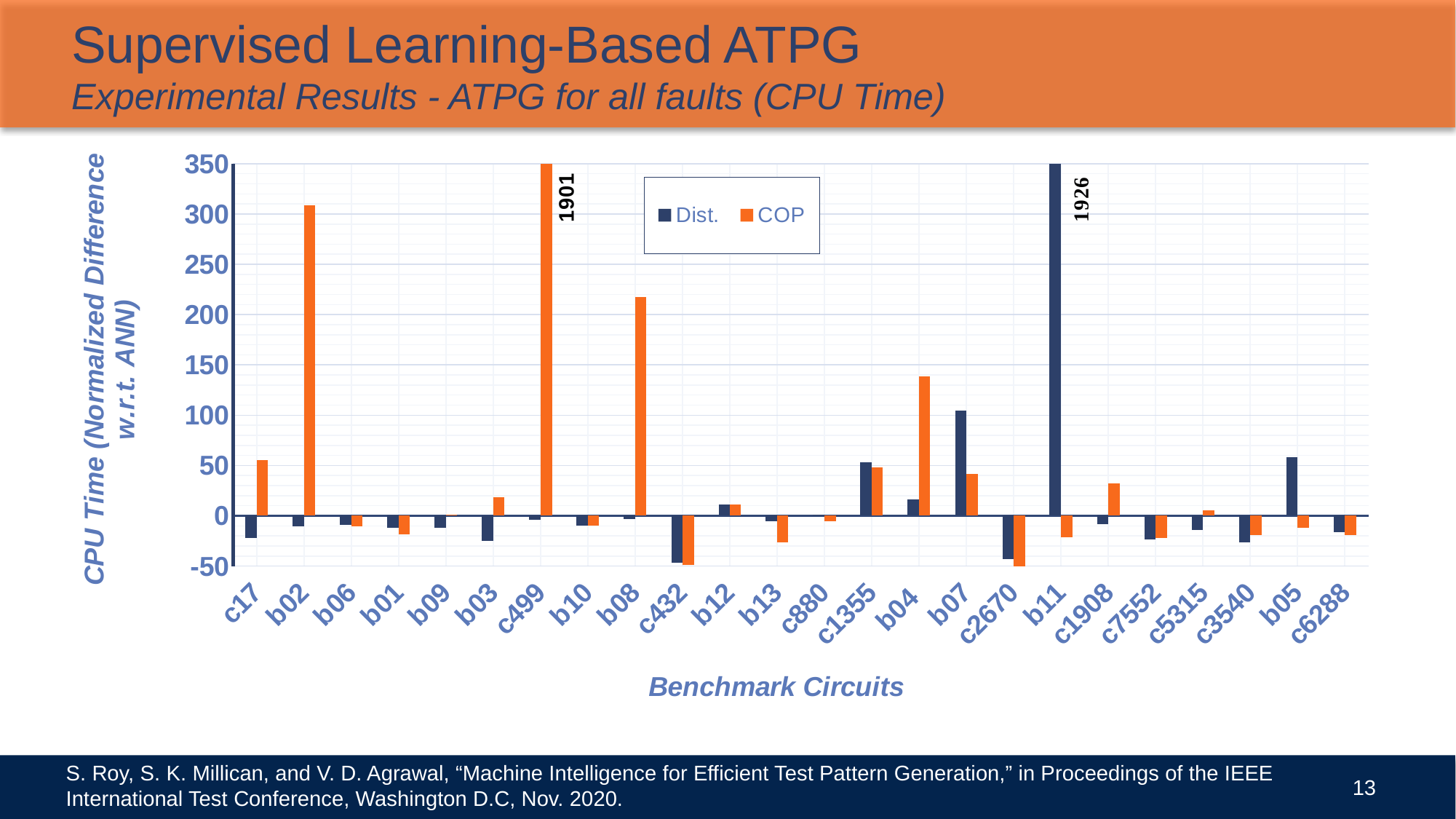
What is the title of the x axis? Benchmark Circuits Is the COP value for b08 greater or less than 200? greater What is the difference between the Dist. value for b11 and the COP value for c499? 25 How many series does the legend list? 2 Which is larger, the COP value for b02 or the COP value for b08? b02 Which benchmark circuit has the highest Dist. value? b11 What is the COP value for c499? 1901 Which benchmark circuit has the highest COP value? c499 What is the Dist. value for b11? 1926 What kind of chart is shown on the slide? bar chart Is the COP value for b04 greater or less than 100? greater How many benchmark circuits are shown on the x axis? 24